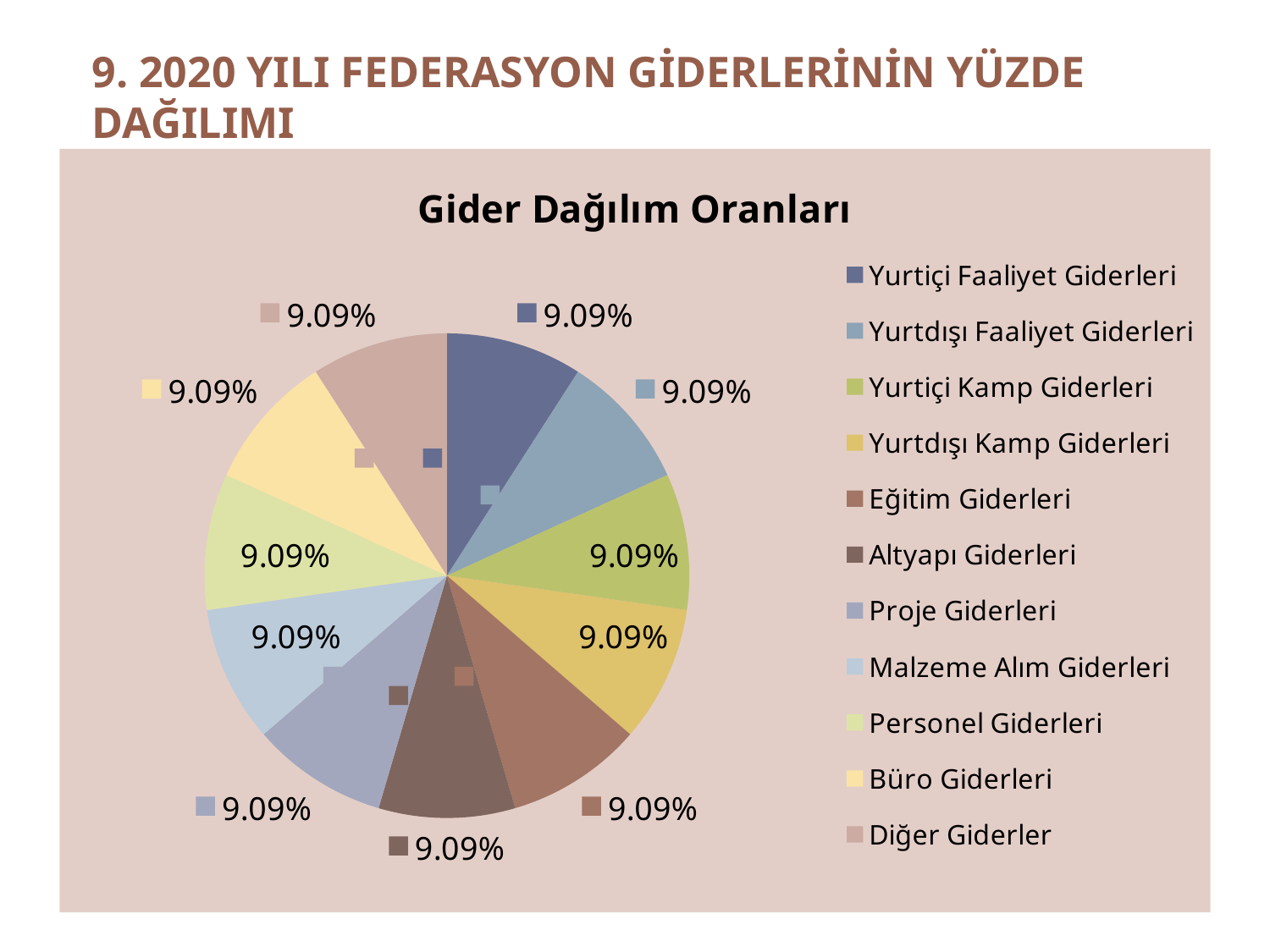
What is the difference between the values for Eğitim Giderleri and Proje Giderleri? 0% What kind of chart is shown on the slide? pie chart What percentage is shown for Diğer Giderler? 9.09% What share of the pie does Büro Giderleri represent? 9.09% What is the title of the chart? Gider Dağılım Oranları What percentage is shown for Yurtiçi Faaliyet Giderleri? 9.09% How many slices does the pie chart have? 11 Is the value for Malzeme Alım Giderleri greater or less than 10%? less What percentage is shown for Personel Giderleri? 9.09% What share of the pie does Altyapı Giderleri represent? 9.09% Which legend entry is listed last? Diğer Giderler How many entries does the legend list? 11